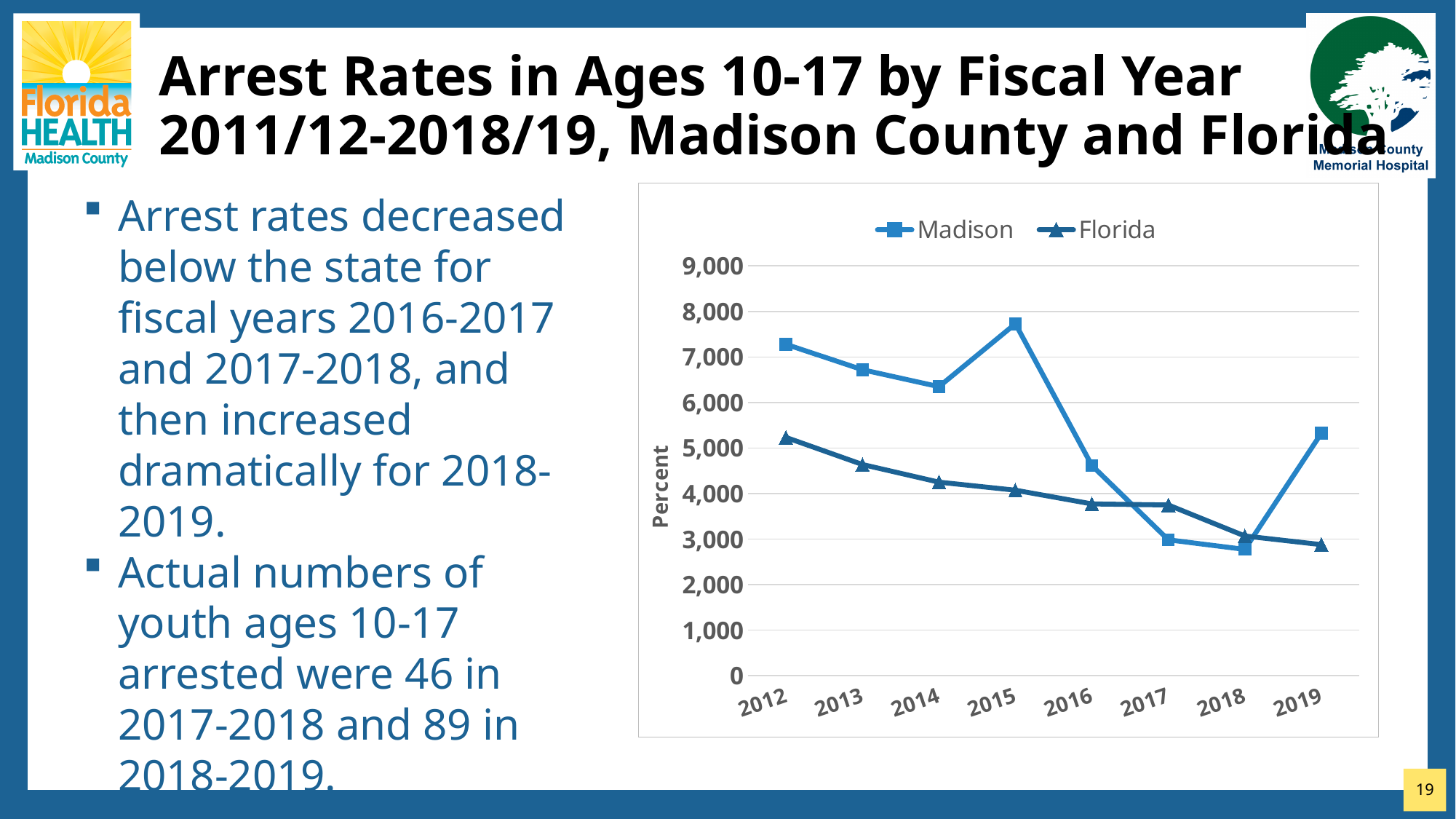
In which year is the Madison arrest rate lowest? 2018 How many series does the legend list? 2 Is the value for Florida in 2012 greater or less than 5,000? greater How many years are plotted along the x axis? 8 In 2016, which series has the higher value, Madison or Florida? Madison In 2018, which series has the higher value, Madison or Florida? Florida In which year is the Florida arrest rate highest? 2012 What kind of chart is shown on the slide? Line chart In which year is the Madison arrest rate highest? 2015 Does the Florida series rise or fall from 2012 to 2019? Fall Is the value for Madison in 2015 greater or less than 7,000? greater Is the value for Madison in 2018 greater or less than 3,000? less